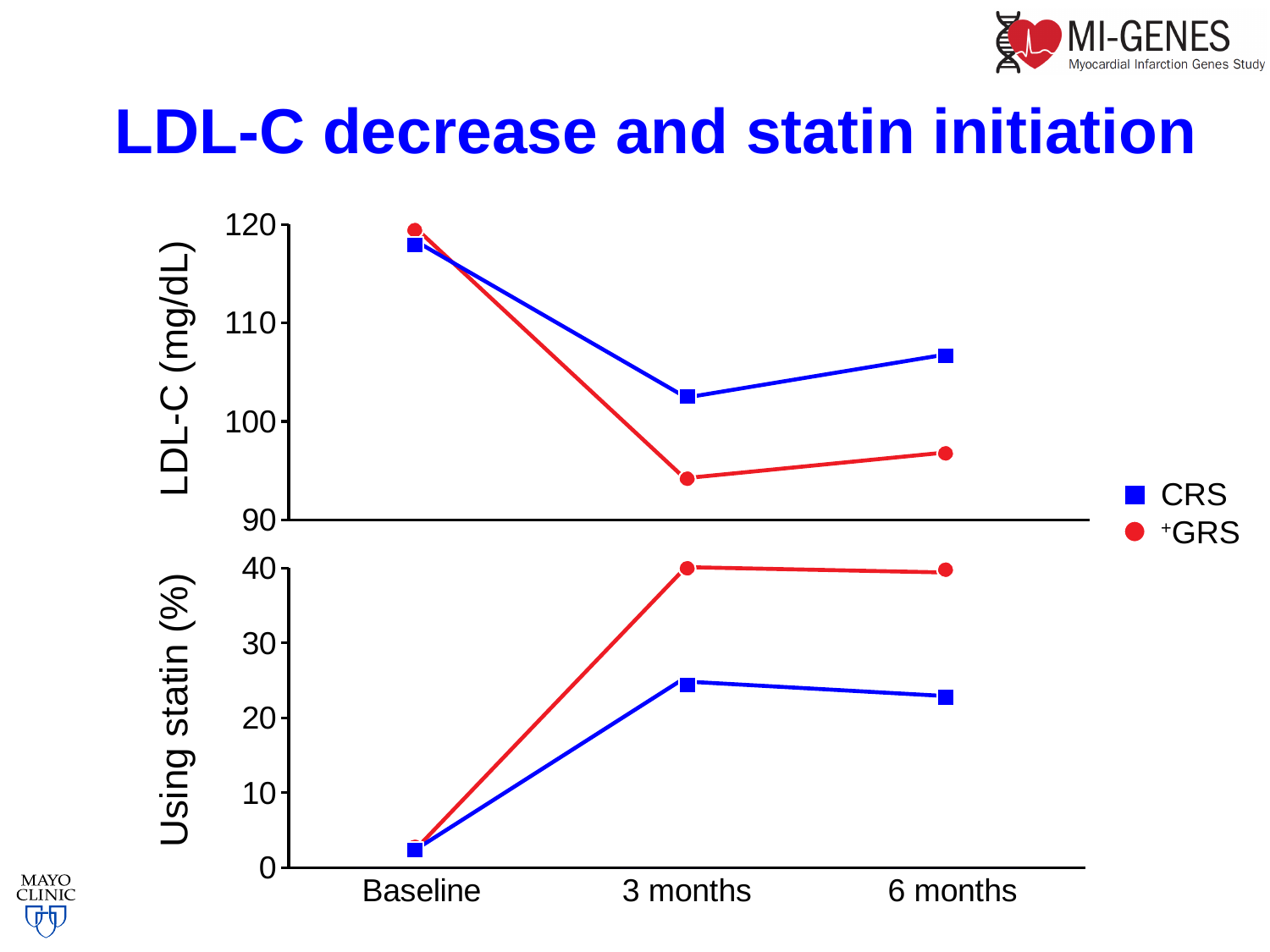
In the bottom chart (Using statin (%)), is the value for CRS at 3 months greater or less than 20? greater In the top chart (LDL-C (mg/dL)), is the value for CRS at 3 months greater or less than 100? greater In the top chart (LDL-C (mg/dL)), which series has the larger value at 6 months, CRS or +GRS? CRS How many series does the legend list? 2 In the bottom chart (Using statin (%)), is the value for +GRS at 6 months greater or less than 30? greater In the top chart (LDL-C (mg/dL)), at which time point is the +GRS value highest? Baseline In the bottom chart (Using statin (%)), which series has the larger value at 3 months, CRS or +GRS? +GRS In the bottom chart (Using statin (%)), does the +GRS line rise or fall from Baseline to 3 months? rise How many time points are shown on the x axis of the bottom chart (Using statin (%))? 3 What kind of chart is the top chart (LDL-C (mg/dL))? line chart What colour is used for the +GRS series? red